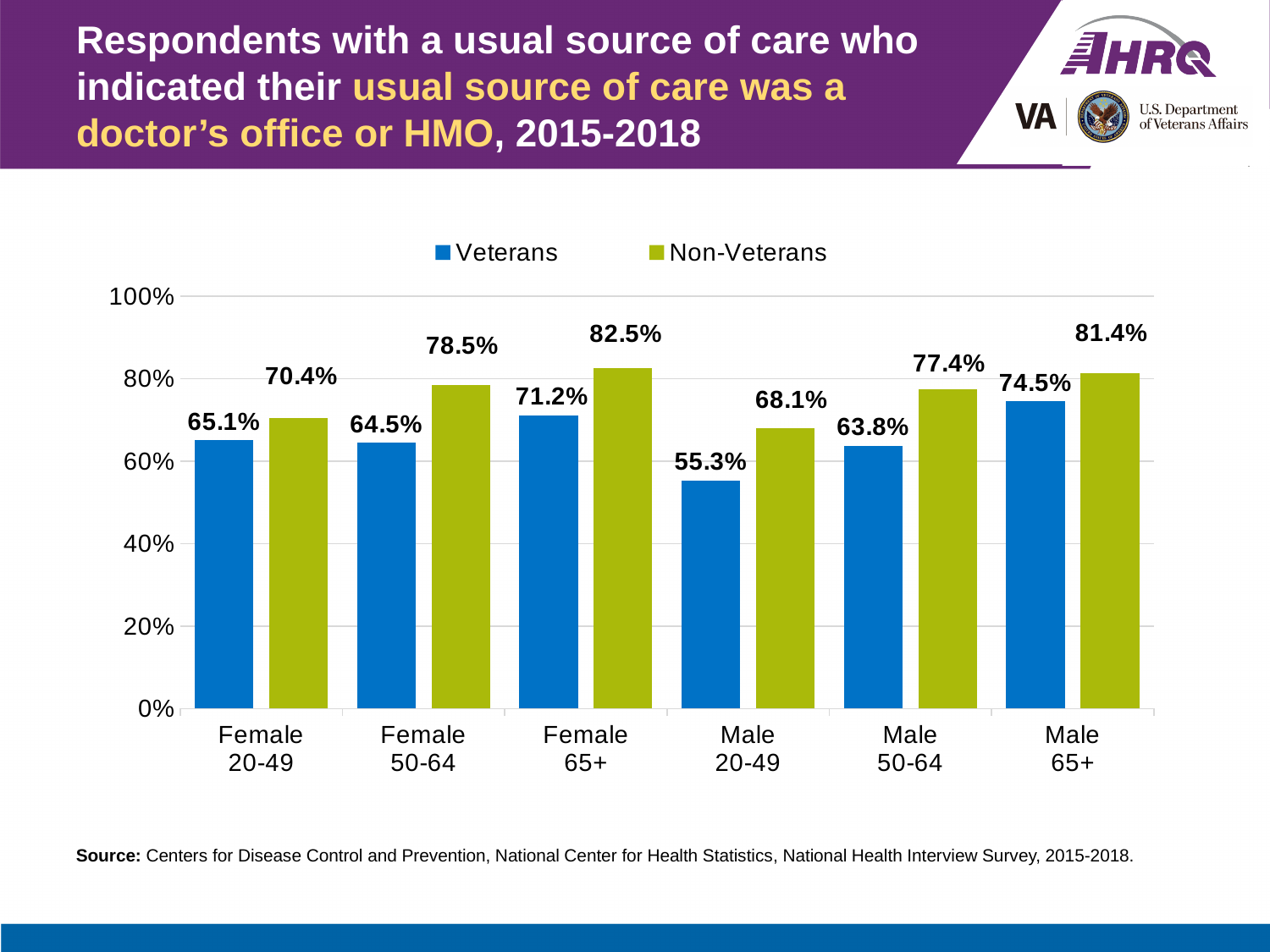
Which is larger in the Female 50-64 category, the Veterans value or the Non-Veterans value? Non-Veterans What colour are the Non-Veterans bars? Green What is the difference between the Non-Veterans and Veterans values in the Male 20-49 category? 12.8% Is the Veterans value for Male 65+ greater or less than 60%? greater How many series does the legend list? 2 What is the value for Veterans in the Male 20-49 category? 55.3% What is the value for Veterans in the Female 20-49 category? 65.1% How many categories are shown on the x axis? 6 What is the value for Non-Veterans in the Male 65+ category? 81.4% Which category has the highest Non-Veterans value? Female 65+ Which category has the lowest Veterans value? Male 20-49 What kind of chart is shown on the slide? Bar chart